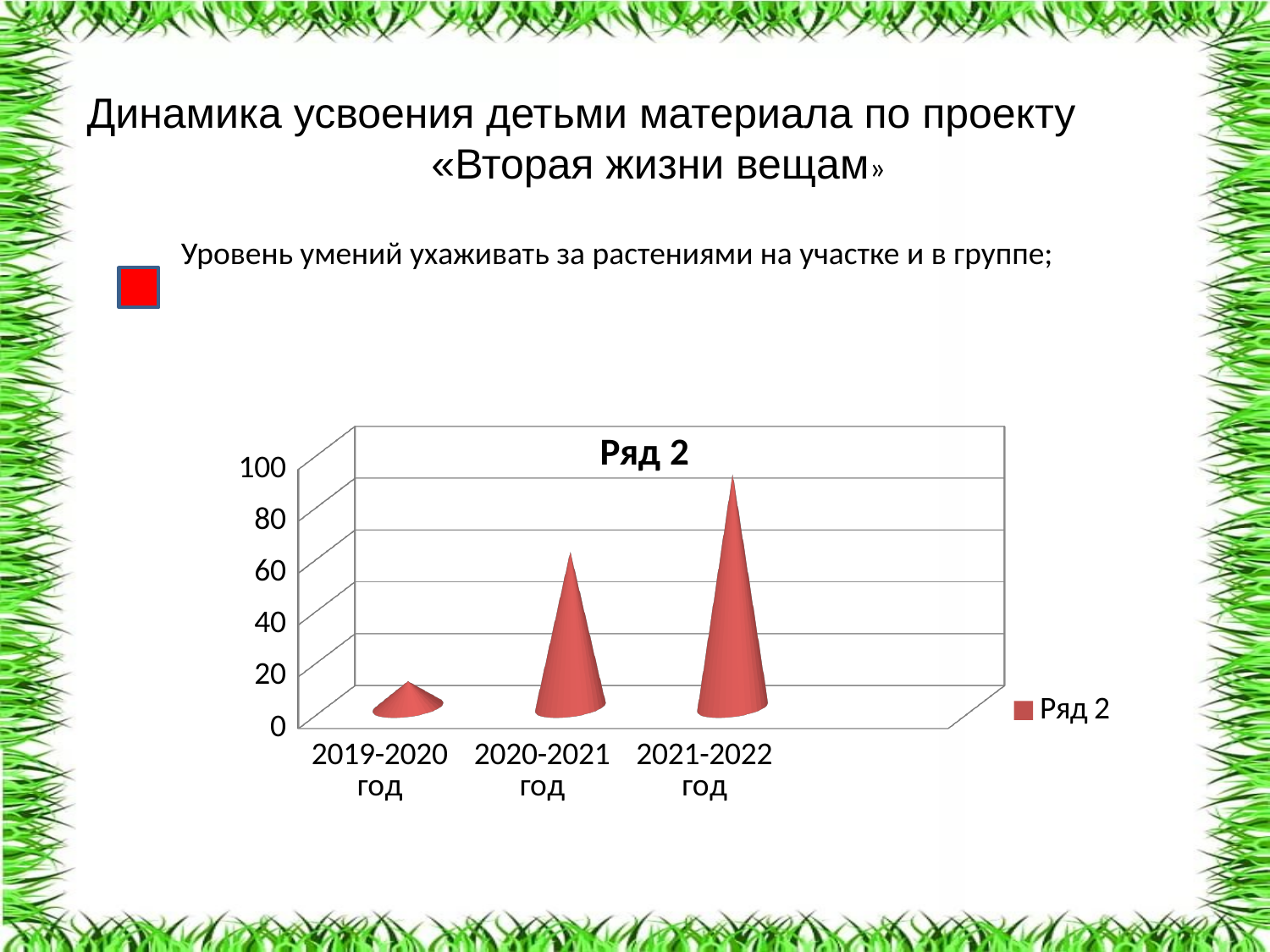
What is the title shown above the chart? Ряд 2 Is the value for 2020-2021 год greater or less than 40? greater How many series does the chart legend list? 1 Which is larger: the value for 2021-2022 год or the value for 2020-2021 год? 2021-2022 год Which is larger: the value for 2020-2021 год or the value for 2019-2020 год? 2020-2021 год Is the value for 2019-2020 год greater or less than 20? less What kind of chart is shown on the slide? bar chart Do the values rise or fall from 2019-2020 год to 2021-2022 год? rise Which category has the lowest value in the chart? 2019-2020 год How many categories are shown on the x axis of the chart? 3 Which category has the highest value in the chart? 2021-2022 год Is the value for 2021-2022 год greater or less than 80? greater